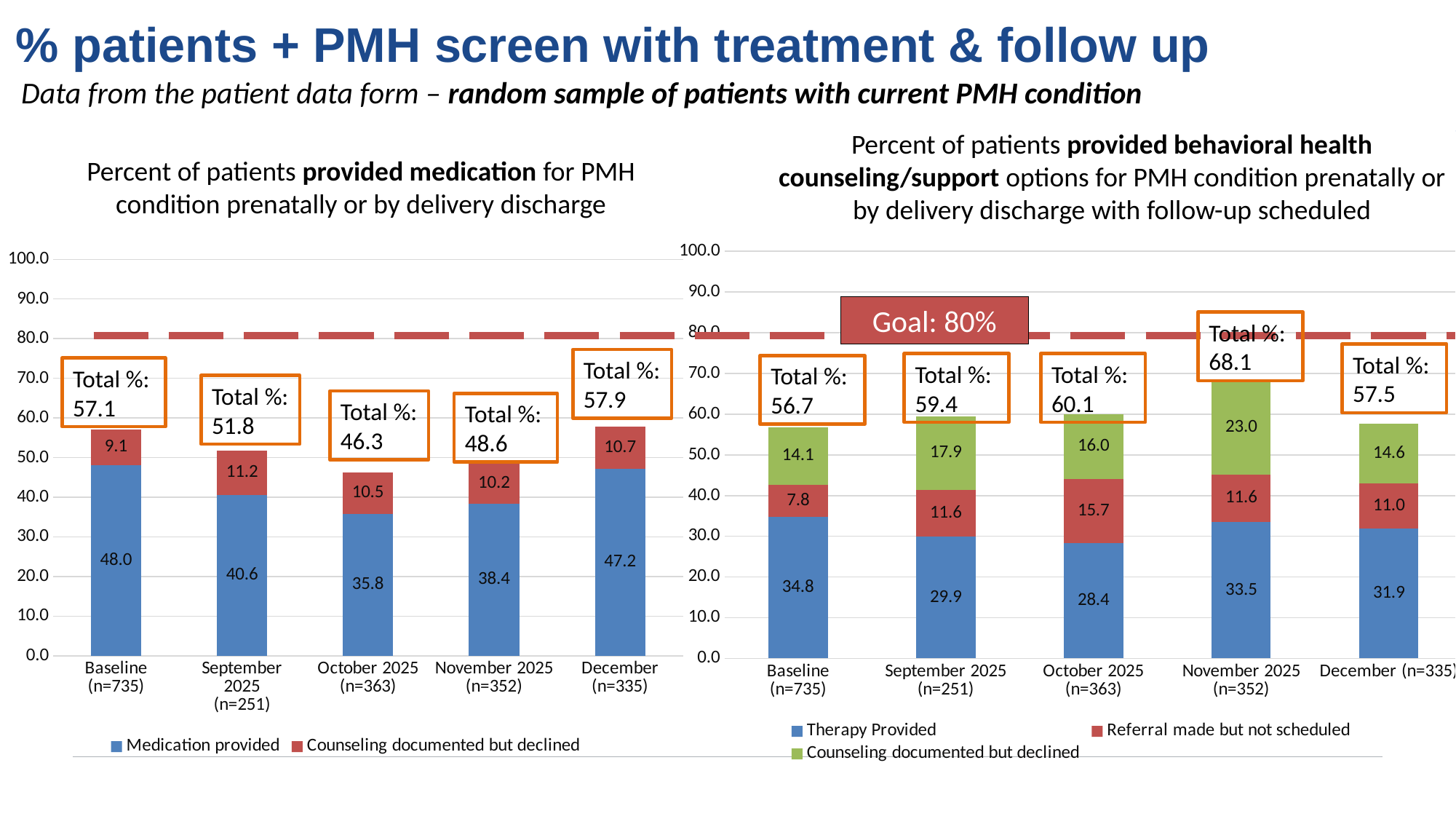
In the left chart (provided medication), what is the Total % for October 2025? 46.3 In the left chart (provided medication), what is the Medication provided value for Baseline (n=735)? 48.0 In the left chart (provided medication), how many series does the legend list? 2 In the right chart (behavioral health counseling/support), how many series does the legend list? 3 In the right chart (behavioral health counseling/support), which category has the highest Total %? November 2025 (n=352) In the left chart (provided medication), which category has the lowest Total %? October 2025 (n=363) What goal percentage is marked by the dashed line on the charts? 80% In the right chart (behavioral health counseling/support), what is the Counseling documented but declined value for November 2025? 23.0 In the right chart (behavioral health counseling/support), what is the Referral made but not scheduled value for October 2025? 15.7 In the left chart (provided medication), what is the difference between the Medication provided values for Baseline and September 2025? 7.4 What type of chart is the left chart (provided medication)? Stacked bar chart In the right chart (behavioral health counseling/support), is the Therapy Provided value for Baseline larger or smaller than for September 2025? larger